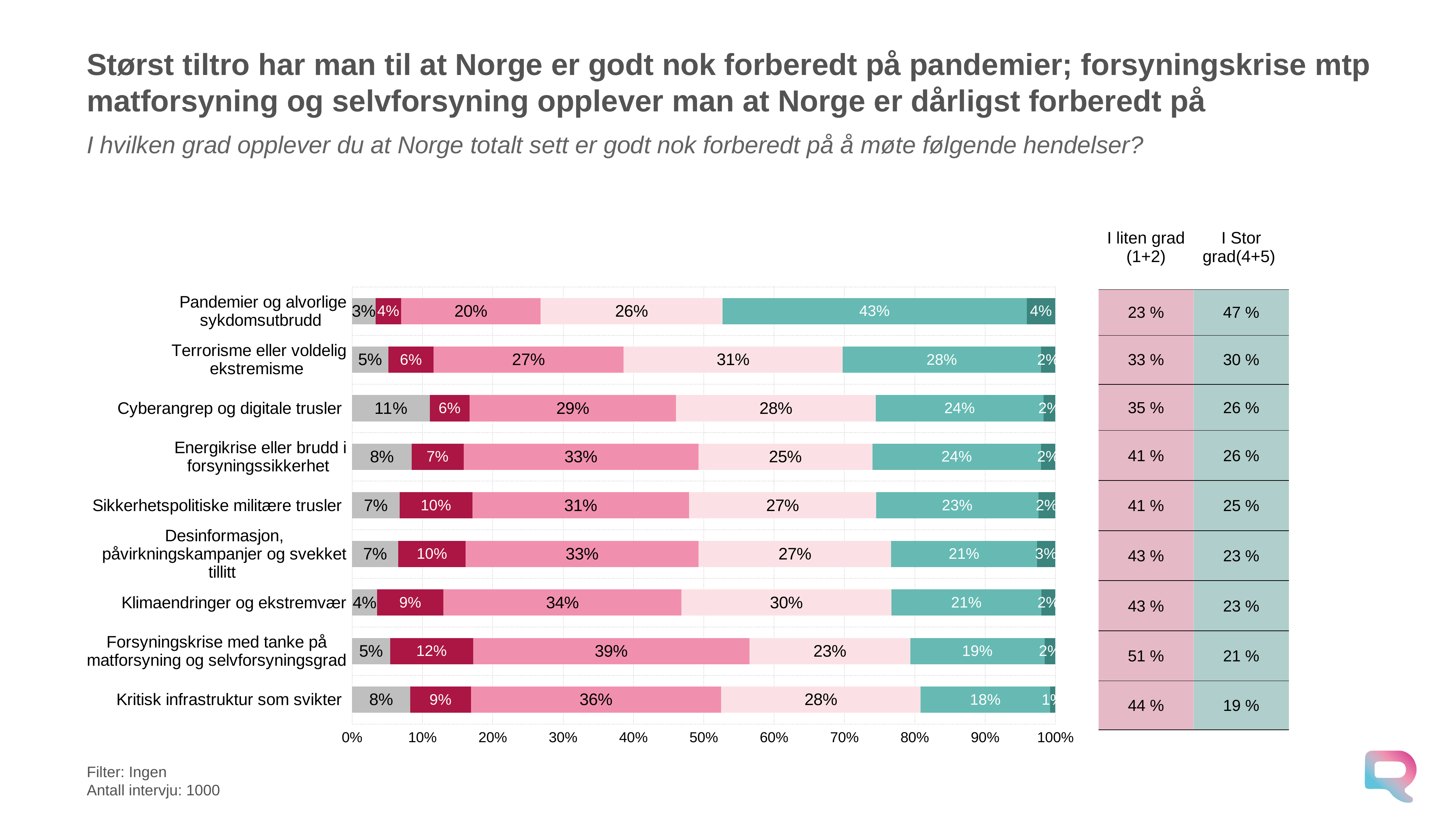
How many categories (events) are plotted in the bar chart? 9 For Pandemier og alvorlige sykdomsutbrudd, what is the difference between the 'I Stor grad (4+5)' value and the 'I liten grad (1+2)' value? 24 percentage points In the side table, what is the 'I Stor grad (4+5)' value for Pandemier og alvorlige sykdomsutbrudd? 47 % What is the value of the first (grey) segment in the bar for Cyberangrep og digitale trusler? 11% For Terrorisme eller voldelig ekstremisme, which is larger: the 'I liten grad (1+2)' value or the 'I Stor grad (4+5)' value? I liten grad (1+2) Which category has the lowest 'I Stor grad (4+5)' value in the side table? Kritisk infrastruktur som svikter What is the value of the dark red segment in the bar for Forsyningskrise med tanke på matforsyning og selvforsyningsgrad? 12% What is the value of the largest segment in the bar for Pandemier og alvorlige sykdomsutbrudd? 43% Which category has the highest 'I liten grad (1+2)' value in the side table? Forsyningskrise med tanke på matforsyning og selvforsyningsgrad What type of chart is shown on the slide? Stacked bar chart Which category has the highest 'I Stor grad (4+5)' value in the side table? Pandemier og alvorlige sykdomsutbrudd In the side table, what is the 'I liten grad (1+2)' value for Forsyningskrise med tanke på matforsyning og selvforsyningsgrad? 51 %